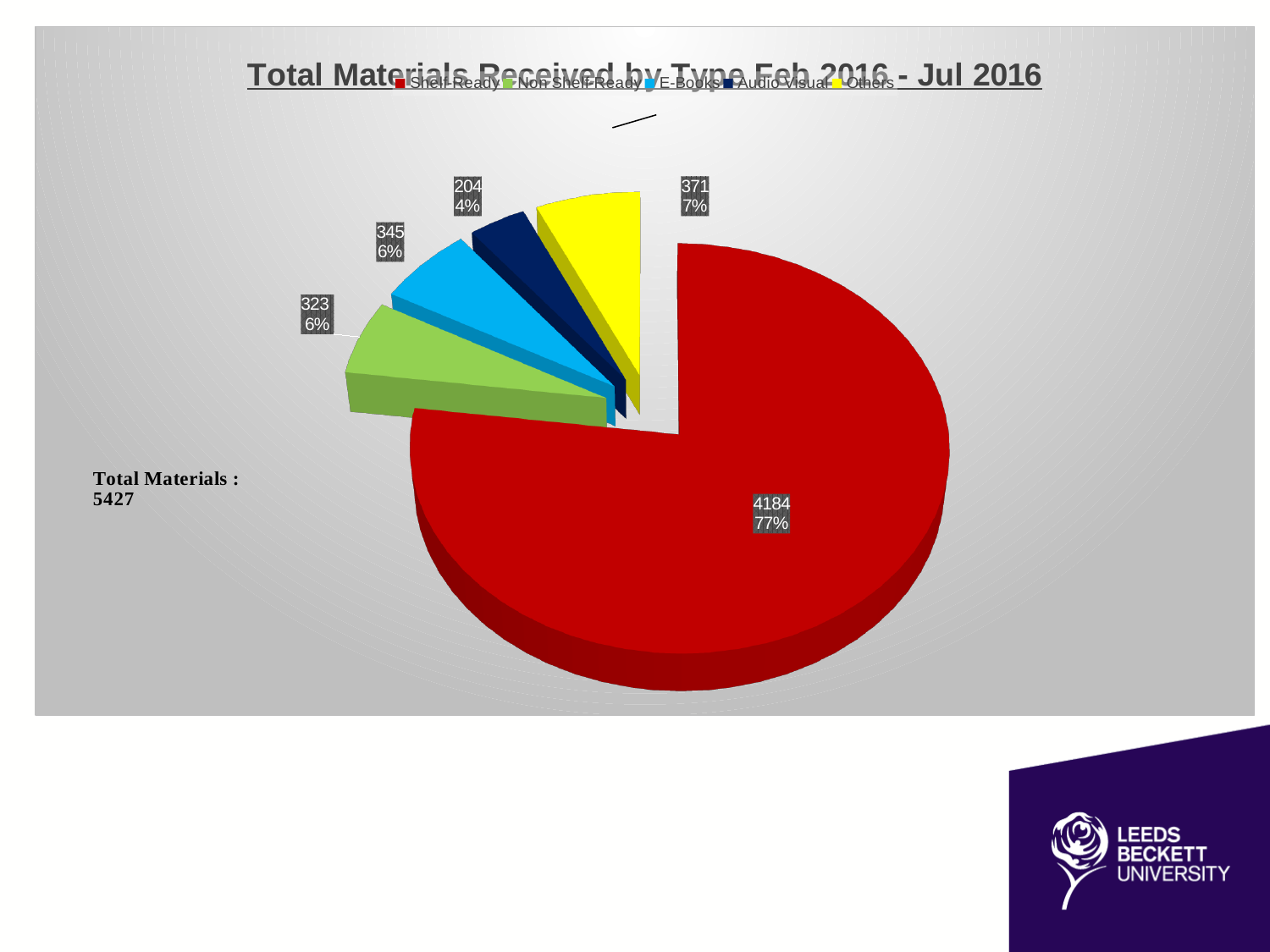
What kind of chart is shown on the slide? pie chart What is the value for Non Shelf Ready? 323 How many slices does the pie chart have? 5 What is the difference between the values for Others and Audio Visual? 167 Which category has the smallest slice? Audio Visual What is the value for Others? 371 What is the value for Shelf Ready? 4184 What percentage share does Audio Visual have? 4% What is the value for E-Books? 345 What percentage share does Shelf Ready have? 77% What is the title of the chart? Total Materials Received by Type Feb 2016 - Jul 2016 Which category has the largest slice? Shelf Ready